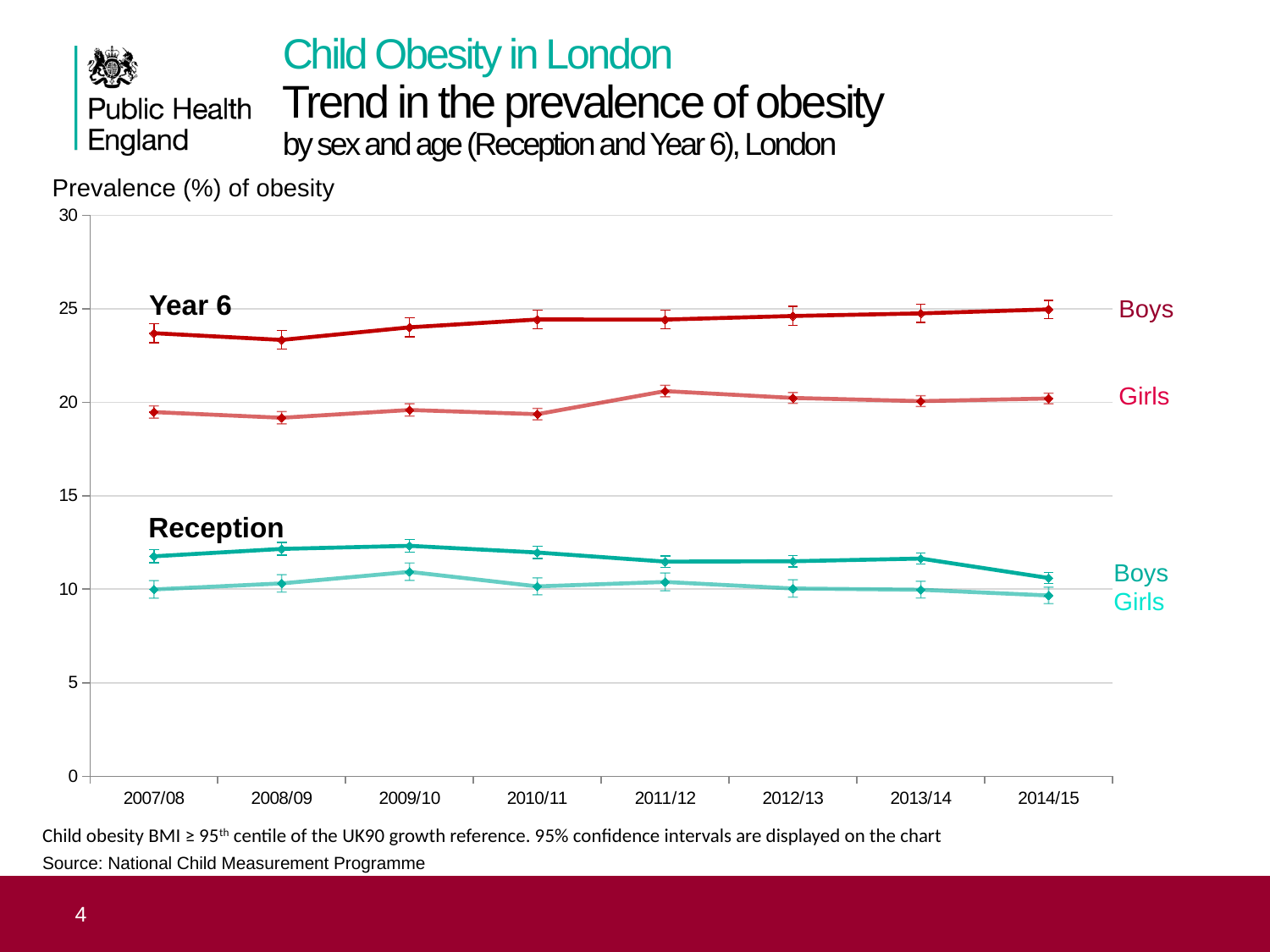
Does the Year 6 Boys line generally rise or fall from 2008/09 to 2014/15? Rise In which year is the Reception Boys line at its lowest? 2014/15 In which year is the Reception Girls line at its highest? 2009/10 Is the value for Year 6 Boys in 2007/08 greater or less than 20? greater What kind of chart is shown on the slide? Line chart Is the value for Year 6 Boys in 2008/09 greater or less than 25? less How many school years are shown along the x axis of the chart? 8 In 2014/15, which is higher: the Year 6 Boys line or the Year 6 Girls line? Year 6 Boys In 2009/10, which is higher: Reception Boys or Reception Girls? Reception Boys Is the value for Reception Boys in 2009/10 greater or less than 10? greater How many lines (series) are plotted on the chart? 4